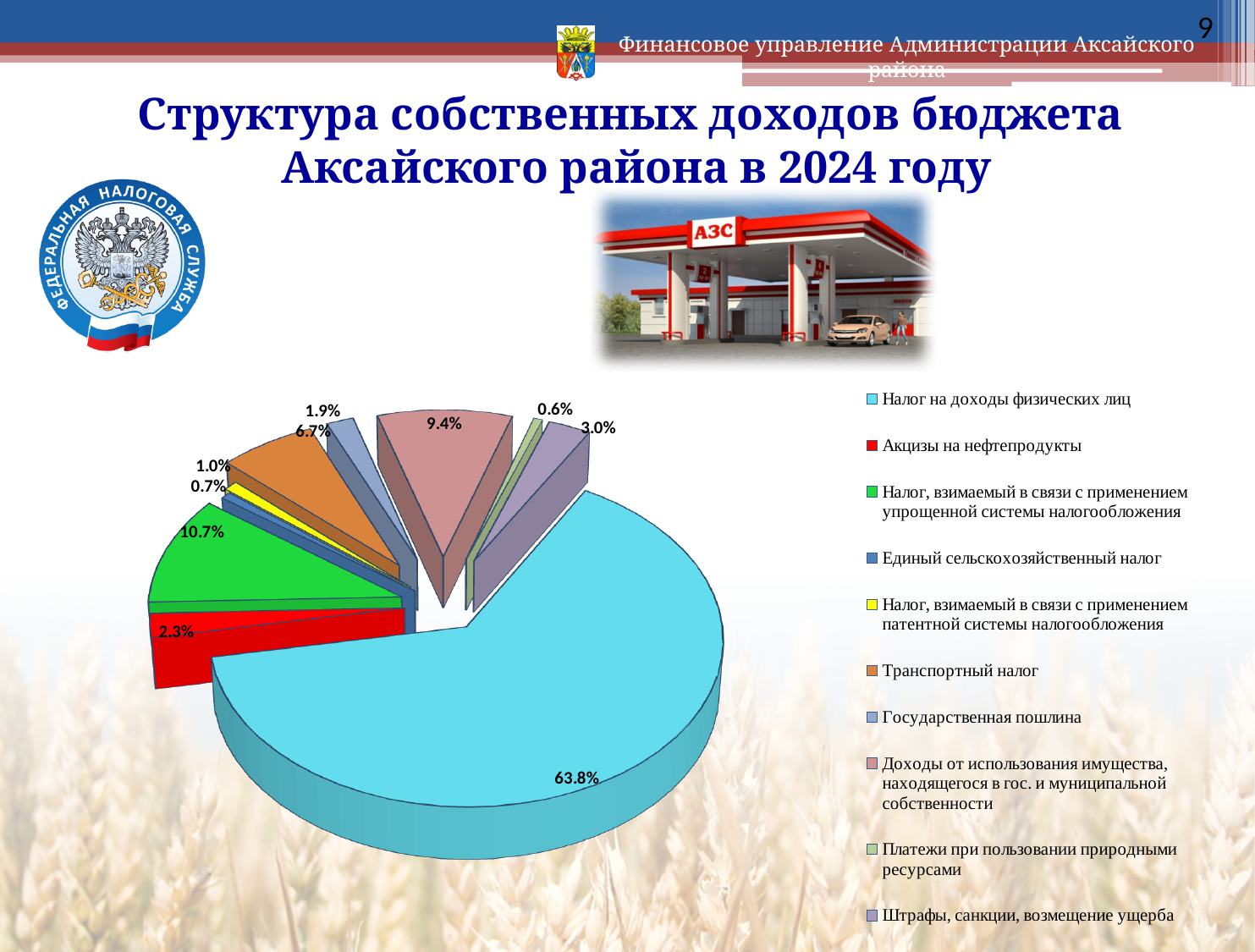
Which category has the largest slice of the pie? Налог на доходы физических лиц What is the value shown for "Акцизы на нефтепродукты"? 2.3% Which is larger: the share for "Государственная пошлина" or the share for "Штрафы, санкции, возмещение ущерба"? Штрафы, санкции, возмещение ущерба What share of the pie does "Налог на доходы физических лиц" represent? 63.8% Which category has the smallest slice of the pie? Платежи при пользовании природными ресурсами What is the value shown for "Налог, взимаемый в связи с применением упрощенной системы налогообложения"? 10.7% What colour is the slice for "Акцизы на нефтепродукты"? red What kind of chart is shown on the slide? pie chart How many categories does the legend of the pie chart list? 10 What is the difference between the shares of "Налог, взимаемый в связи с применением упрощенной системы налогообложения" and "Транспортный налог"? 4.0% What is the value shown for "Транспортный налог"? 6.7% What is the value shown for "Доходы от использования имущества, находящегося в гос. и муниципальной собственности"? 9.4%